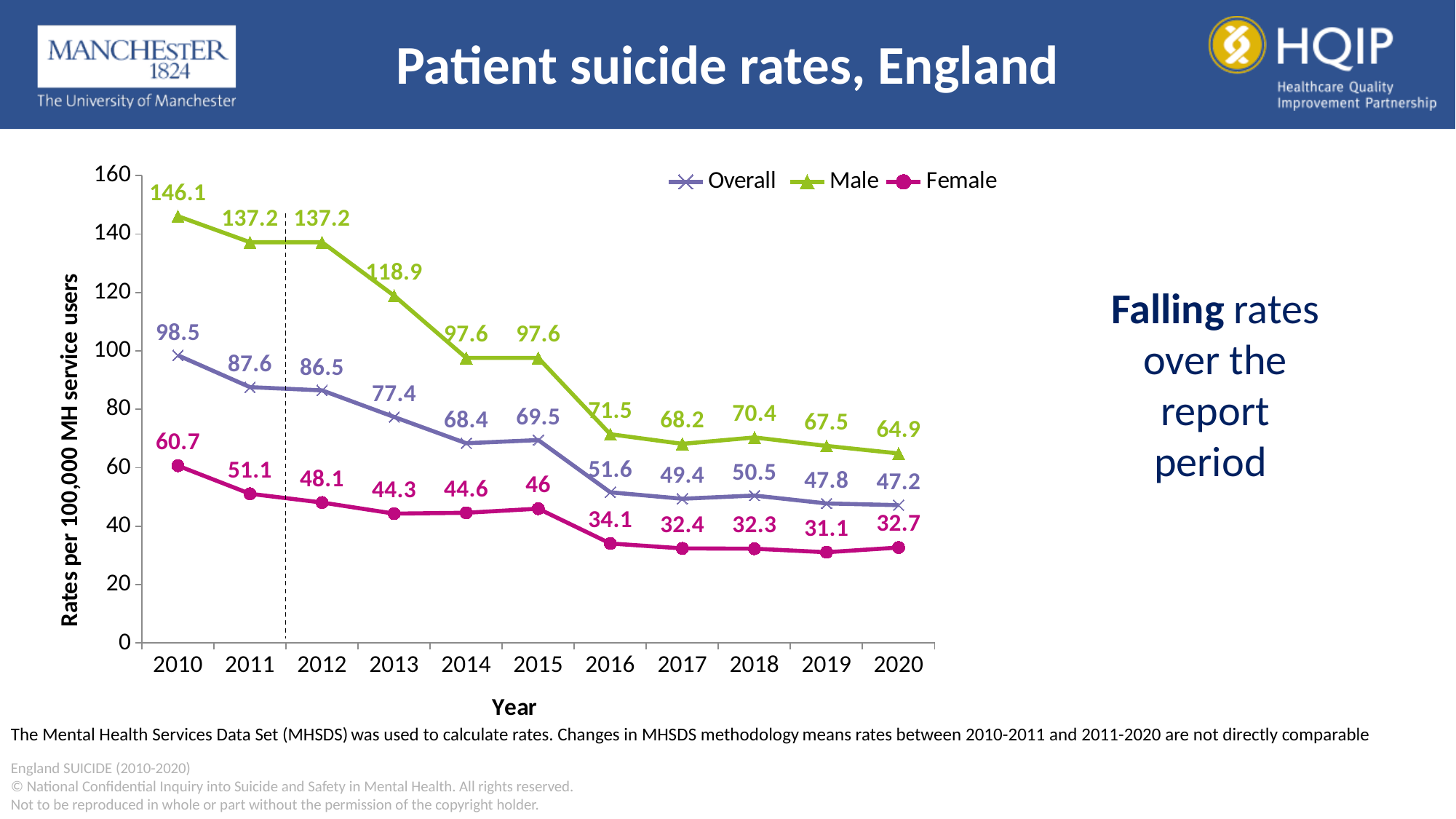
In which year is the Overall rate lowest? 2020 How many years are shown on the x axis? 11 What kind of chart is shown on the slide? line chart What is the Female rate in 2019? 31.1 What is the Male rate in 2010? 146.1 In which year is the Female rate highest? 2010 Which is larger, the Overall rate in 2015 or the Overall rate in 2014? 2015 Is the Male rate in 2013 greater or less than 100? greater How many series does the legend list? 3 What is the difference between the Male rate in 2010 and the Male rate in 2020? 81.2 Do the Male rates generally rise or fall from 2010 to 2020? fall What is the Overall rate in 2020? 47.2